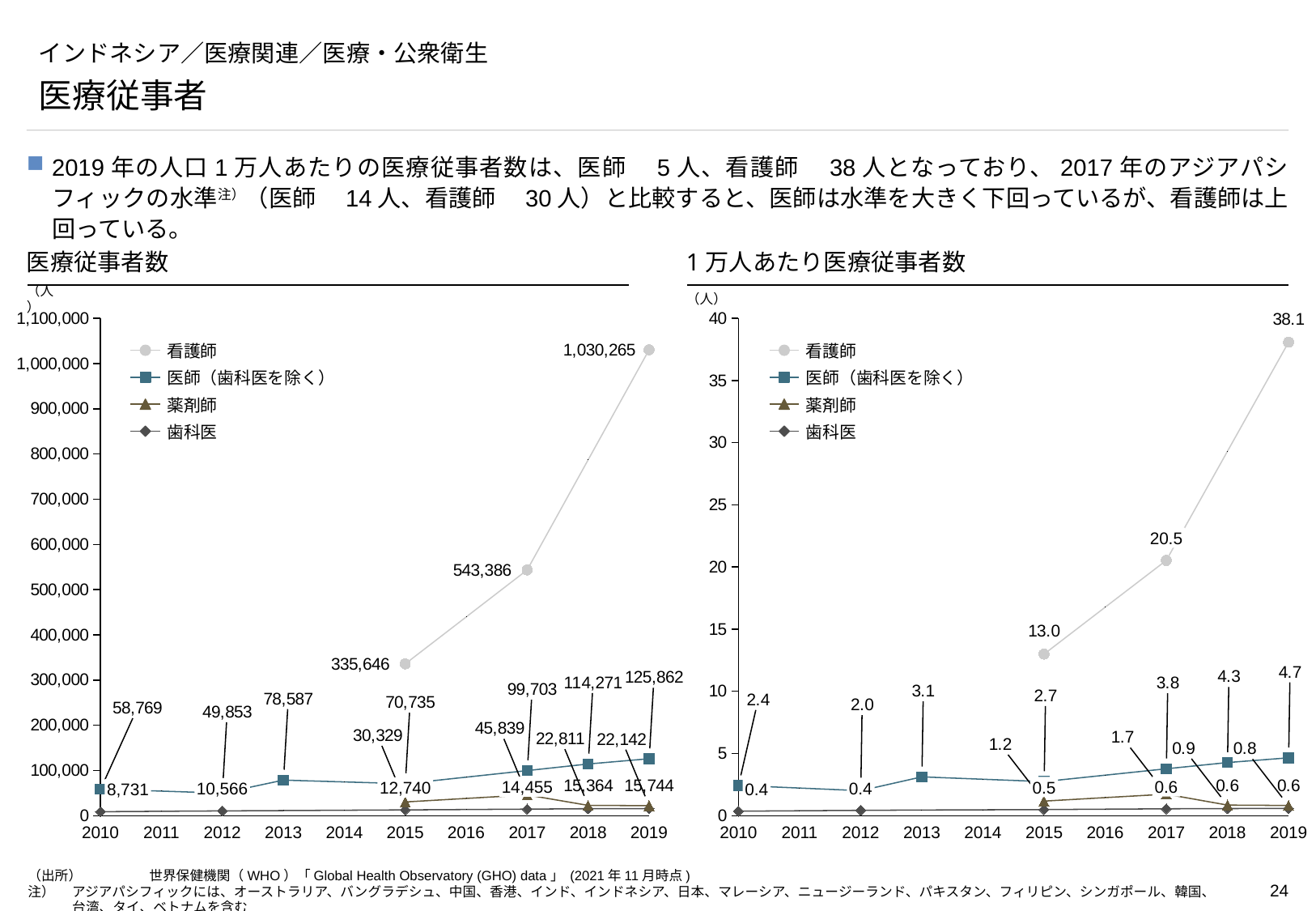
In the right chart (1万人あたり医療従事者数), which is larger: 医師（歯科医を除く） in 2019 or 薬剤師 in 2019? 医師（歯科医を除く） In the left chart (医療従事者数), how many series does the legend list? 4 In the left chart (医療従事者数), what is the value for 歯科医 in 2010? 8,731 In the left chart (医療従事者数), what is the value for 医師（歯科医を除く） in 2013? 78,587 What kind of chart is the right chart (1万人あたり医療従事者数)? line chart In the right chart (1万人あたり医療従事者数), how many years are shown on the x axis? 10 In the right chart (1万人あたり医療従事者数), what is the value for 薬剤師 in 2018? 0.9 In the right chart (1万人あたり医療従事者数), is the value for 看護師 in 2019 greater or less than 35? greater In the left chart (医療従事者数), what is the value for 看護師 in 2019? 1,030,265 In the right chart (1万人あたり医療従事者数), what is the value for 看護師 in 2017? 20.5 In the left chart (医療従事者数), which series has the highest value in 2019? 看護師 In the left chart (医療従事者数), what is the difference between the 看護師 values in 2019 and 2017? 486,879